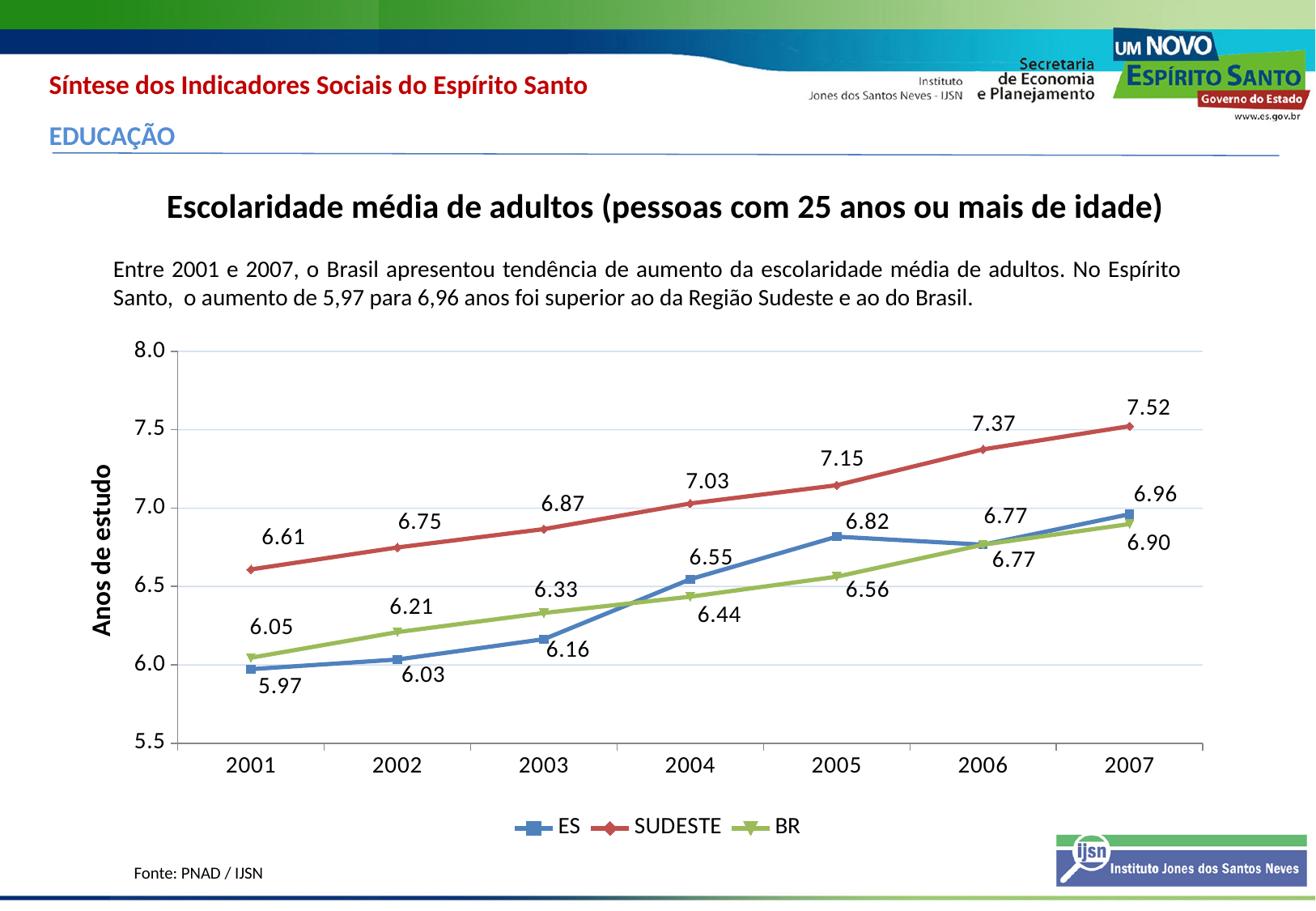
What is the label of the y axis? Anos de estudo What is the difference between the SUDESTE and ES values in 2001? 0.64 What is the value for ES in 2001? 5.97 How many series does the legend list? 3 In which year is the SUDESTE series lowest? 2001 What is the value for SUDESTE in 2007? 7.52 In which year is the ES series highest? 2007 What type of chart is shown on the slide? line chart Does the SUDESTE series rise or fall from 2001 to 2007? rise What is the value for BR in 2004? 6.44 Which is larger in 2005, the value for ES or the value for BR? ES How many years are shown on the x axis? 7